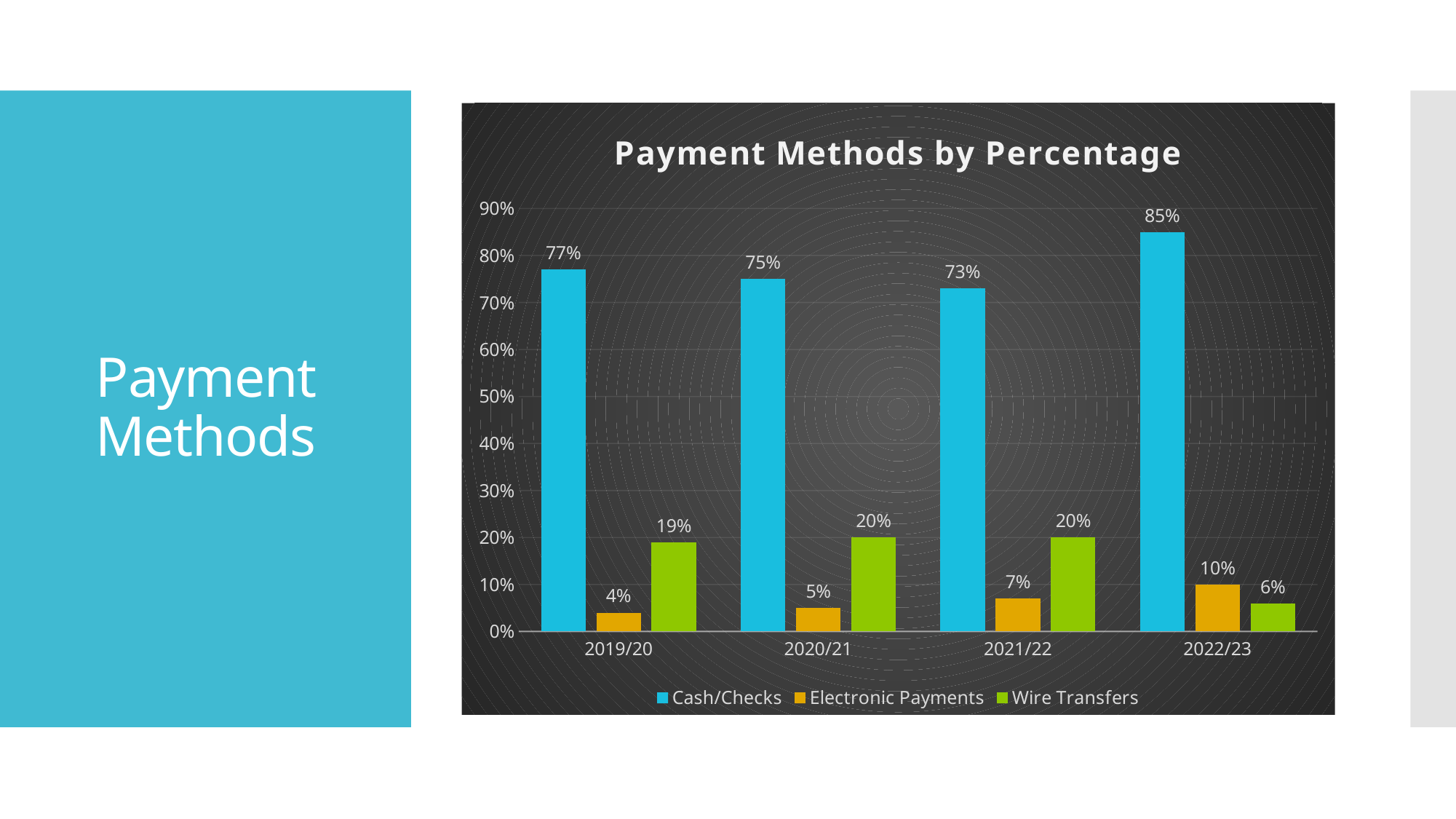
In which year is the Electronic Payments value lowest? 2019/20 Does the Electronic Payments value rise or fall from 2019/20 to 2022/23? Rise What is the difference between the Cash/Checks values for 2022/23 and 2021/22? 12% What is the value for Electronic Payments in 2020/21? 5% Which is larger in 2022/23: Electronic Payments or Wire Transfers? Electronic Payments What is the value for Wire Transfers in 2019/20? 19% What kind of chart is shown on the slide? Bar chart How many years are shown on the x axis? 4 What is the value for Cash/Checks in 2022/23? 85% In which year is the Cash/Checks value highest? 2022/23 How many series does the legend list? 3 What is the title of the chart? Payment Methods by Percentage